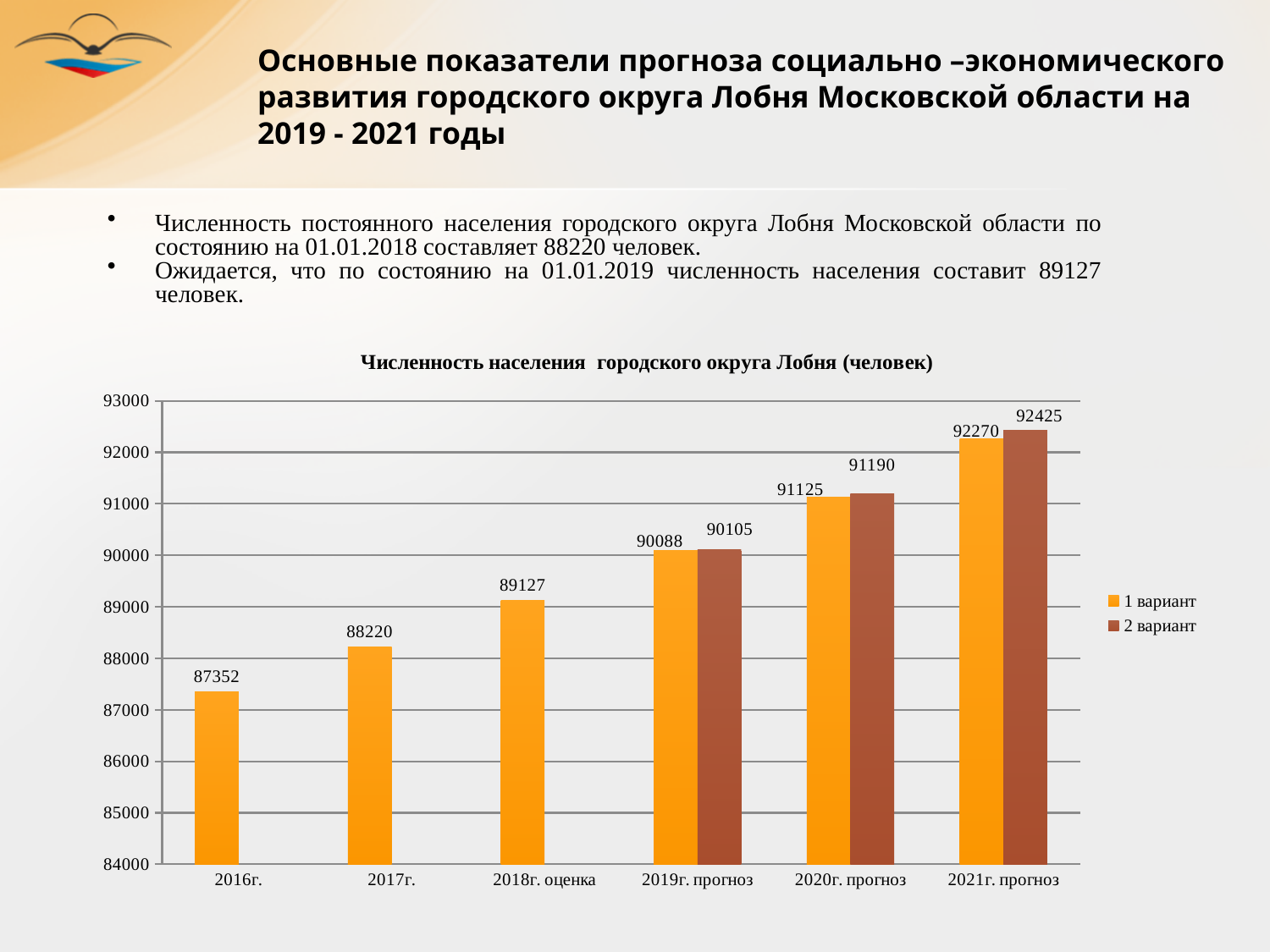
What is the value of the 1 вариант series for 2019г. прогноз? 90088 How many series does the legend list? 2 Which is larger for 2021г. прогноз: 1 вариант or 2 вариант? 2 вариант What is the difference between the 2 вариант and 1 вариант values for 2020г. прогноз? 65 Which category has the lowest value in the chart? 2016г. Which bar has the highest value in the chart? 2 вариант for 2021г. прогноз What is the value of the 2 вариант series for 2021г. прогноз? 92425 Do the values rise or fall from 2016г. to 2021г. прогноз? rise What is the difference between the values for 2017г. and 2016г.? 868 How many categories are shown on the x axis? 6 What is the value for 2016г. in the chart? 87352 What kind of chart is shown on the slide? bar chart